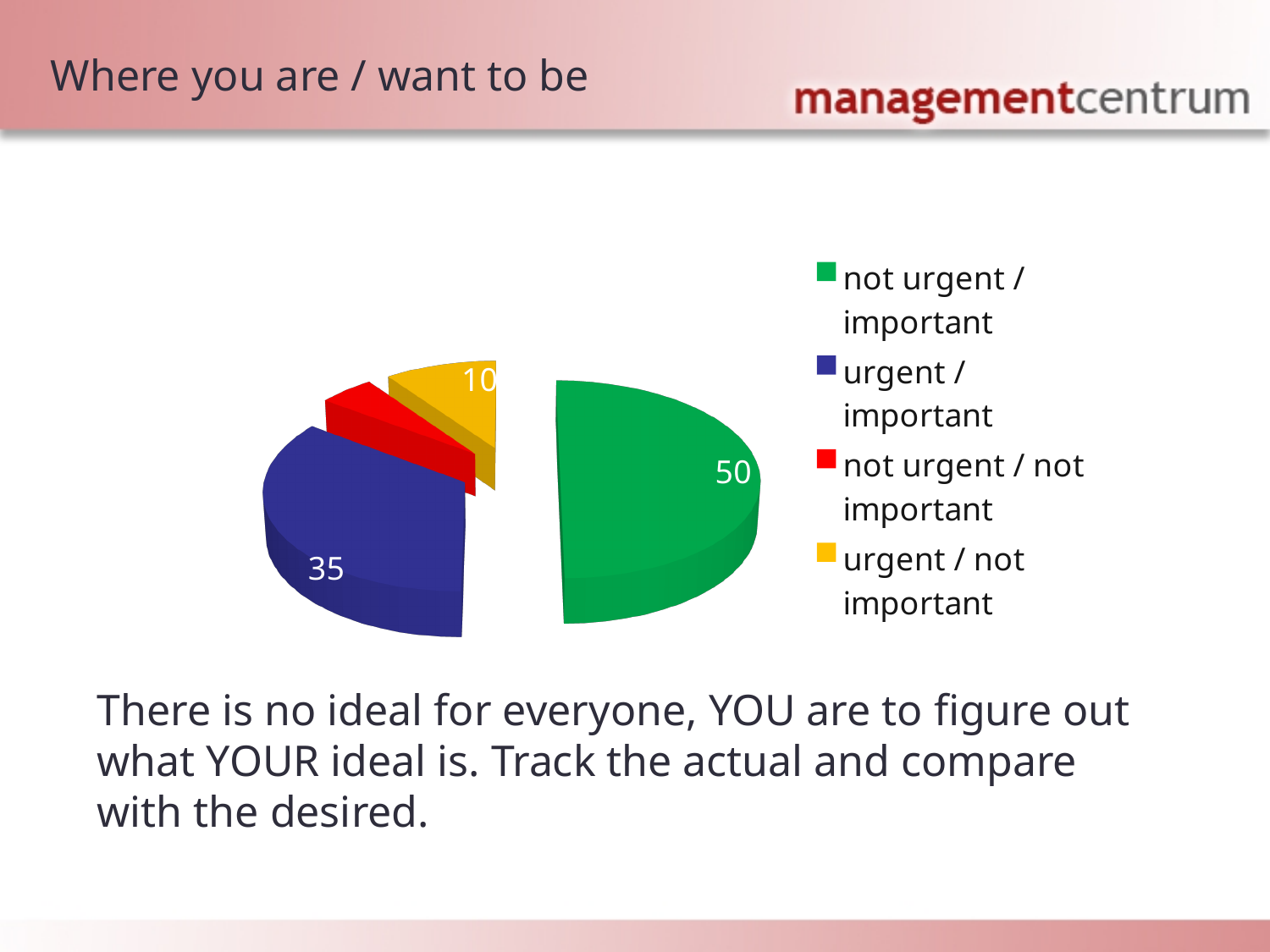
How many entries does the legend list? 4 What is the value for the 'urgent / important' slice? 35 Which category has the smallest slice of the pie? not urgent / not important What is the difference between the 'not urgent / important' and 'urgent / not important' values? 40 What colour is the 'urgent / important' slice? blue What type of chart is shown on the slide? pie chart What is the difference between the 'not urgent / important' and 'urgent / important' values? 15 What is the value for the 'urgent / not important' slice? 10 What is the value for the 'not urgent / important' slice? 50 How many slices does the pie chart have? 4 Which category has the largest slice of the pie? not urgent / important Which is larger, the 'urgent / important' slice or the 'urgent / not important' slice? urgent / important